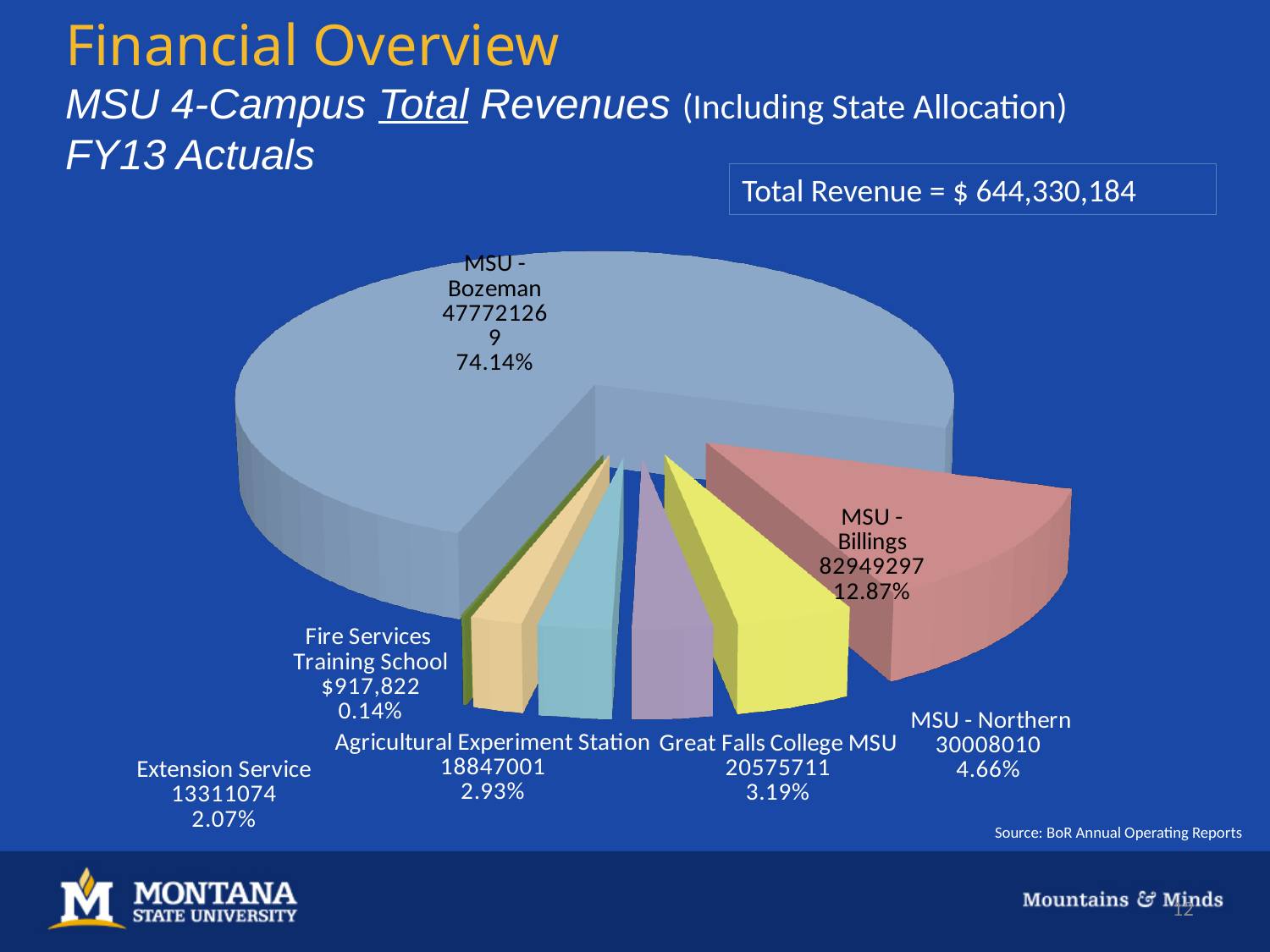
What is the revenue value shown for MSU - Northern? 30008010 Which category has the largest slice of the pie? MSU - Bozeman What percentage share of the pie does MSU - Bozeman represent? 74.14% What is the revenue value shown for MSU - Billings? 82949297 Which category has the smallest slice of the pie? Fire Services Training School How many slices does the pie chart have? 7 What percentage share of the pie does Great Falls College MSU represent? 3.19% What is the difference between the revenue for MSU - Billings and MSU - Northern? 52941287 What type of chart is shown on the slide? pie chart What total revenue figure is stated in the box above the chart? $ 644,330,184 What is the revenue value shown for Fire Services Training School? $917,822 Which is larger, the revenue for Agricultural Experiment Station or for Extension Service? Agricultural Experiment Station